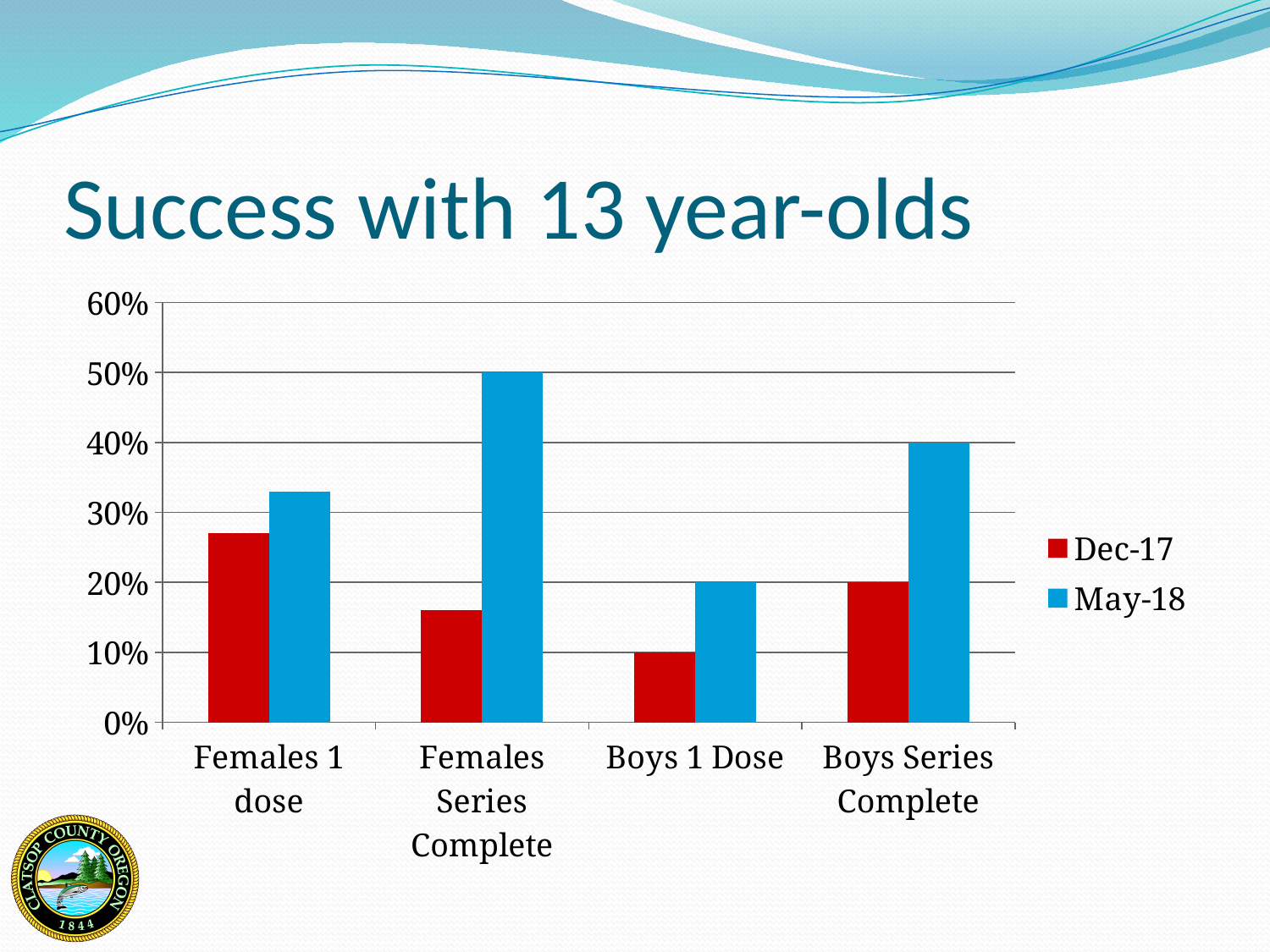
What is the May-18 value for Females Series Complete? 50% What is the difference between the May-18 and Dec-17 values for Boys Series Complete? 20% What is the title of the slide containing the chart? Success with 13 year-olds How many categories are shown on the x axis? 4 What is the Dec-17 value for Boys 1 Dose? 10% Which is larger for Females Series Complete, the Dec-17 value or the May-18 value? May-18 What kind of chart is shown on the slide? bar chart How many series does the legend list? 2 Is the Dec-17 value for Females 1 dose greater or less than 20%? greater Which category has the lowest Dec-17 value? Boys 1 Dose Which category has the highest May-18 value? Females Series Complete What is the May-18 value for Boys Series Complete? 40%